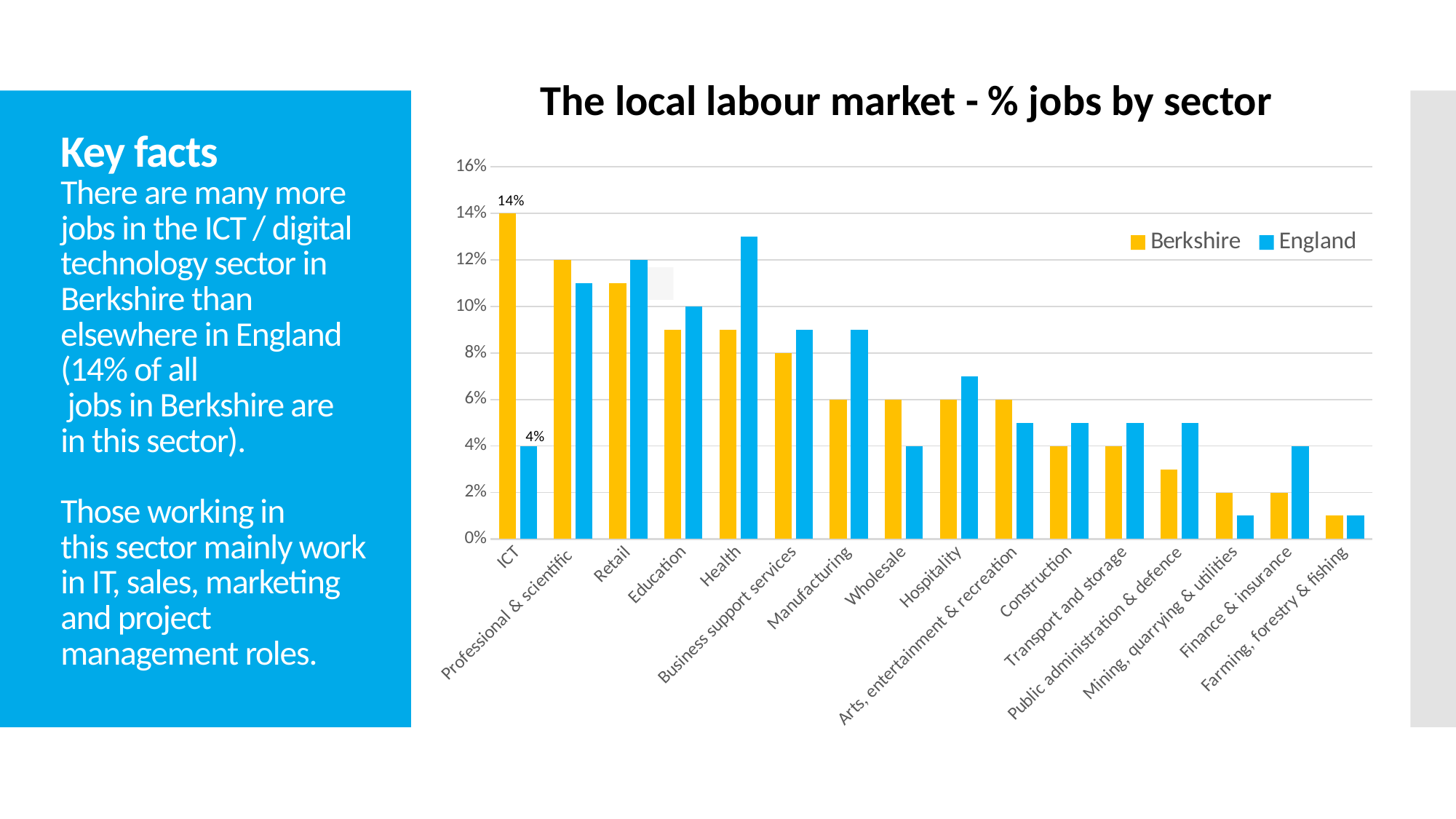
Which sector has the highest England value? Health What is the difference between the Berkshire and England values for ICT? 10% Which sector has the highest Berkshire value? ICT What percentage of jobs in Berkshire are in the ICT sector? 14% What percentage of jobs in England are in the ICT sector? 4% How many series does the legend list? 2 Which is larger for Manufacturing, the Berkshire value or the England value? England Which is larger for Finance & insurance, the Berkshire value or the England value? England Is the Berkshire value for Public administration & defence greater or less than 4%? less What type of chart is shown? Bar chart How many sectors are shown on the x axis? 16 Is the England value for Health greater or less than 12%? greater